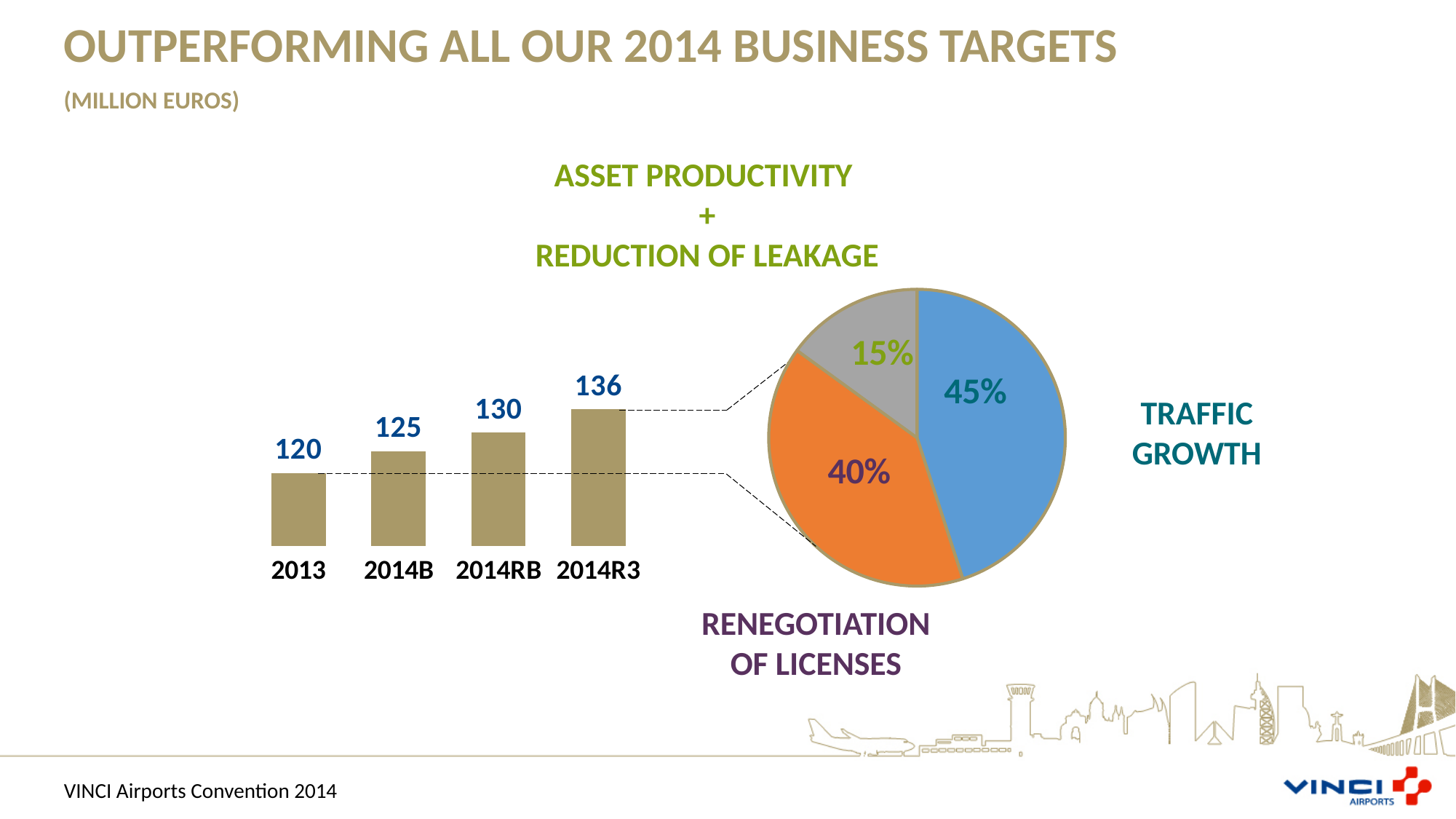
In the pie chart on the right, which slice is the smallest? Asset Productivity + Reduction of Leakage In the bar chart on the left, what is the difference between the values for 2014R3 and 2013? 16 In the bar chart on the left, which category has the highest value? 2014R3 In the bar chart on the left, what is the value for 2014R3? 136 In the bar chart on the left, what is the value for 2014B? 125 What kind of chart is shown on the right of the slide? pie chart In the bar chart on the left, what is the value for 2013? 120 In the bar chart on the left, how many categories are shown? 4 In the pie chart on the right, what share is labelled Renegotiation of Licenses? 40% In the bar chart on the left, which category has the lowest value? 2013 In the bar chart on the left, do the values rise or fall from 2013 to 2014R3? rise In the pie chart on the right, what share is labelled Traffic Growth? 45%